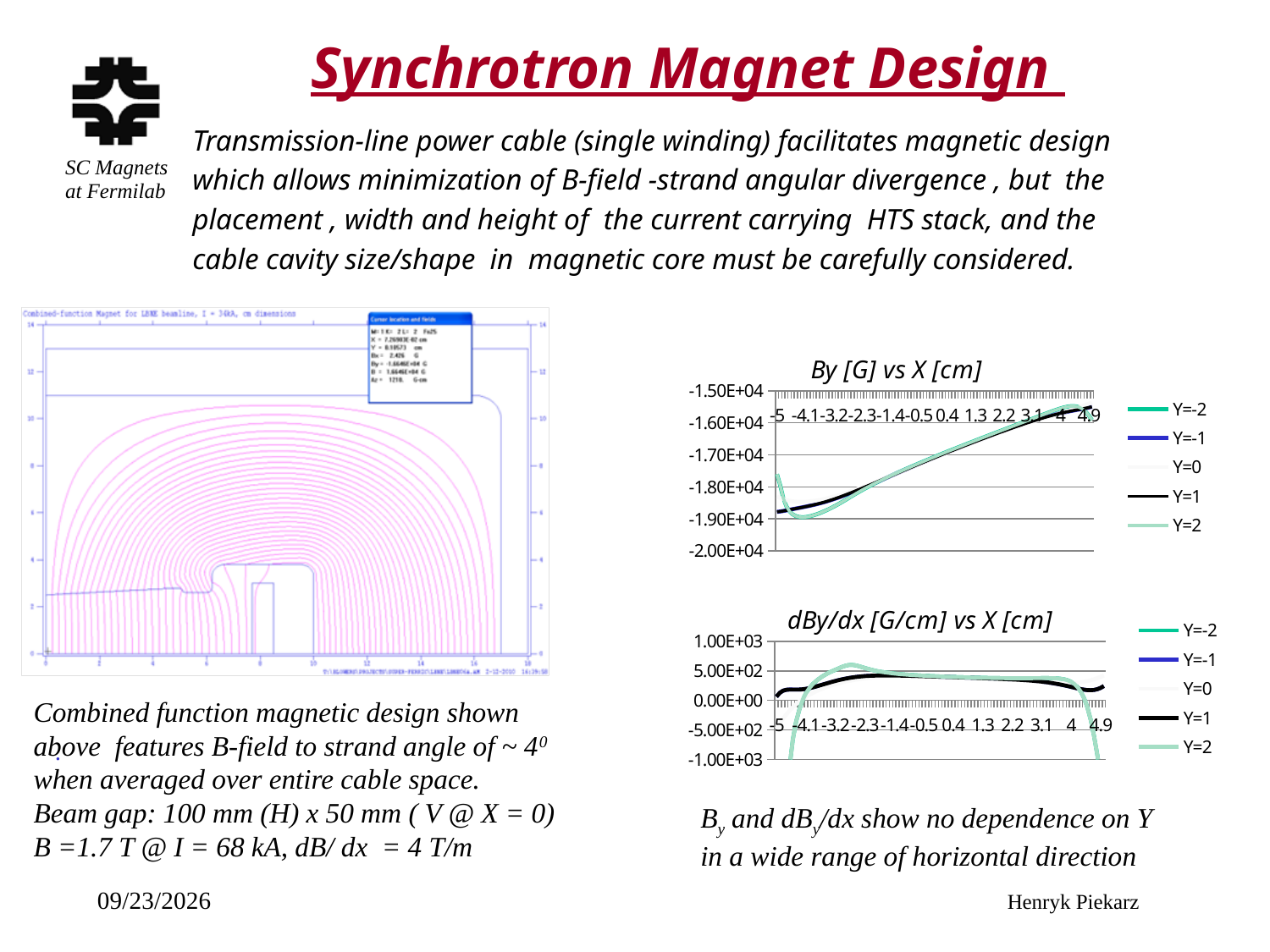
In the "By [G] vs X [cm]" chart, is the value of By at X = 4.9 greater or less than -1.60E+04? greater How many series does the legend of the "dBy/dx [G/cm] vs X [cm]" chart list? 5 What kind of chart is the "By [G] vs X [cm]" chart? line chart In the "By [G] vs X [cm]" chart, do the By values rise or fall as X increases from -5 to 4.9? rise In the "dBy/dx [G/cm] vs X [cm]" chart, is the value of dBy/dx at X = 1.3 greater or less than 1.00E+03? less How many series does the legend of the "By [G] vs X [cm]" chart list? 5 What is the lowest value labelled on the vertical axis of the "By [G] vs X [cm]" chart? -2.00E+04 In the "By [G] vs X [cm]" chart, is the value of By at X = -4.1 greater or less than -1.80E+04? less What kind of chart is the "dBy/dx [G/cm] vs X [cm]" chart? line chart How many X-axis tick labels are shown on the "dBy/dx [G/cm] vs X [cm]" chart? 12 In the "By [G] vs X [cm]" chart, what are the legend entries? Y=-2, Y=-1, Y=0, Y=1, Y=2